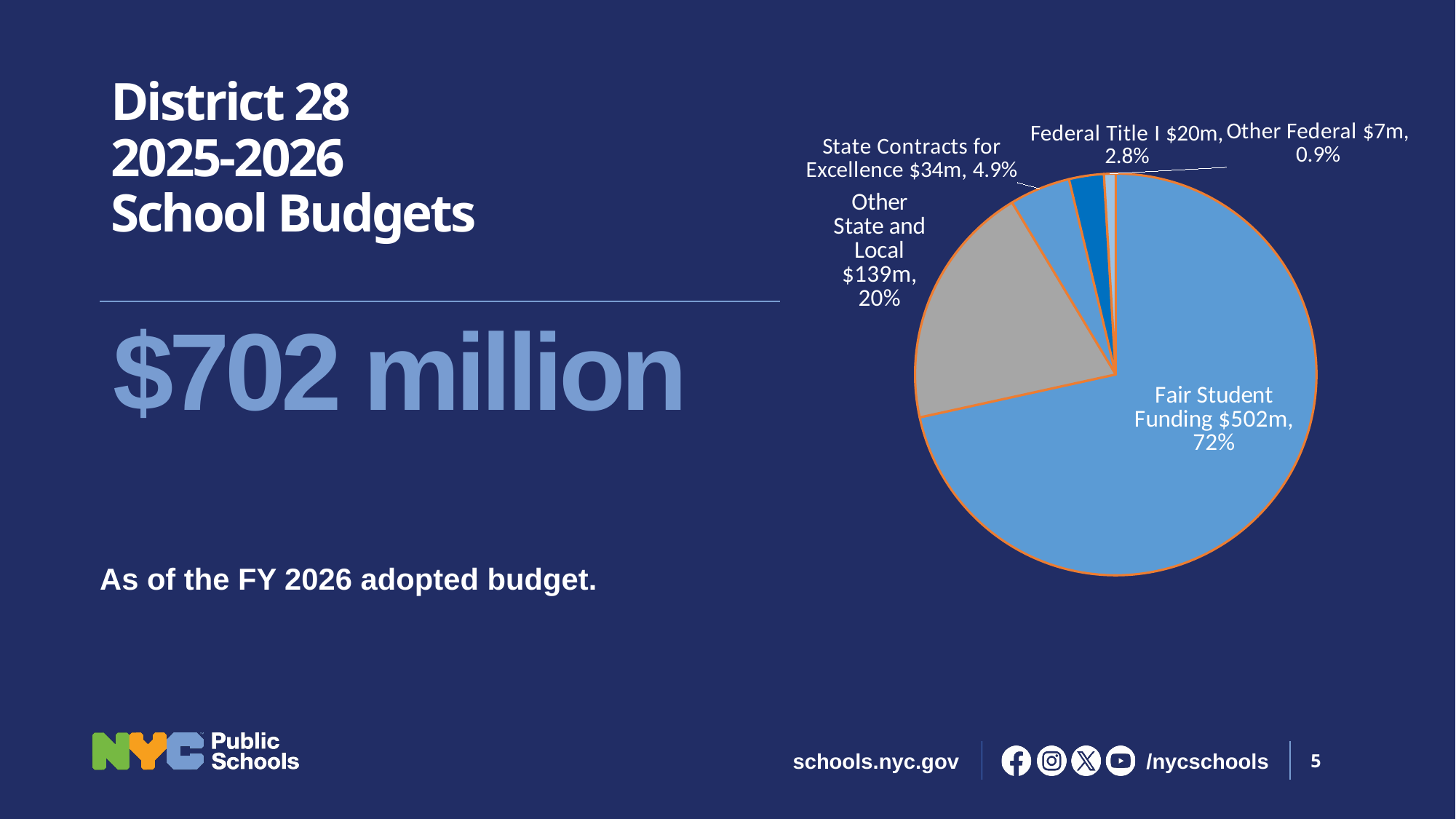
Which category has the largest slice of the pie? Fair Student Funding How many slices does the pie chart have? 5 What share of the pie does Other State and Local represent? 20% Which is larger, Federal Title I or Other Federal? Federal Title I What kind of chart is shown on the slide? Pie chart What is the difference in dollars between Fair Student Funding and Other State and Local? $363m What share of the pie does Fair Student Funding represent? 72% What is the value for Fair Student Funding in the pie chart? $502m What is the value for State Contracts for Excellence? $34m What is the value for Other State and Local in the pie chart? $139m What share of the pie does Federal Title I represent? 2.8% Which category has the smallest slice of the pie? Other Federal